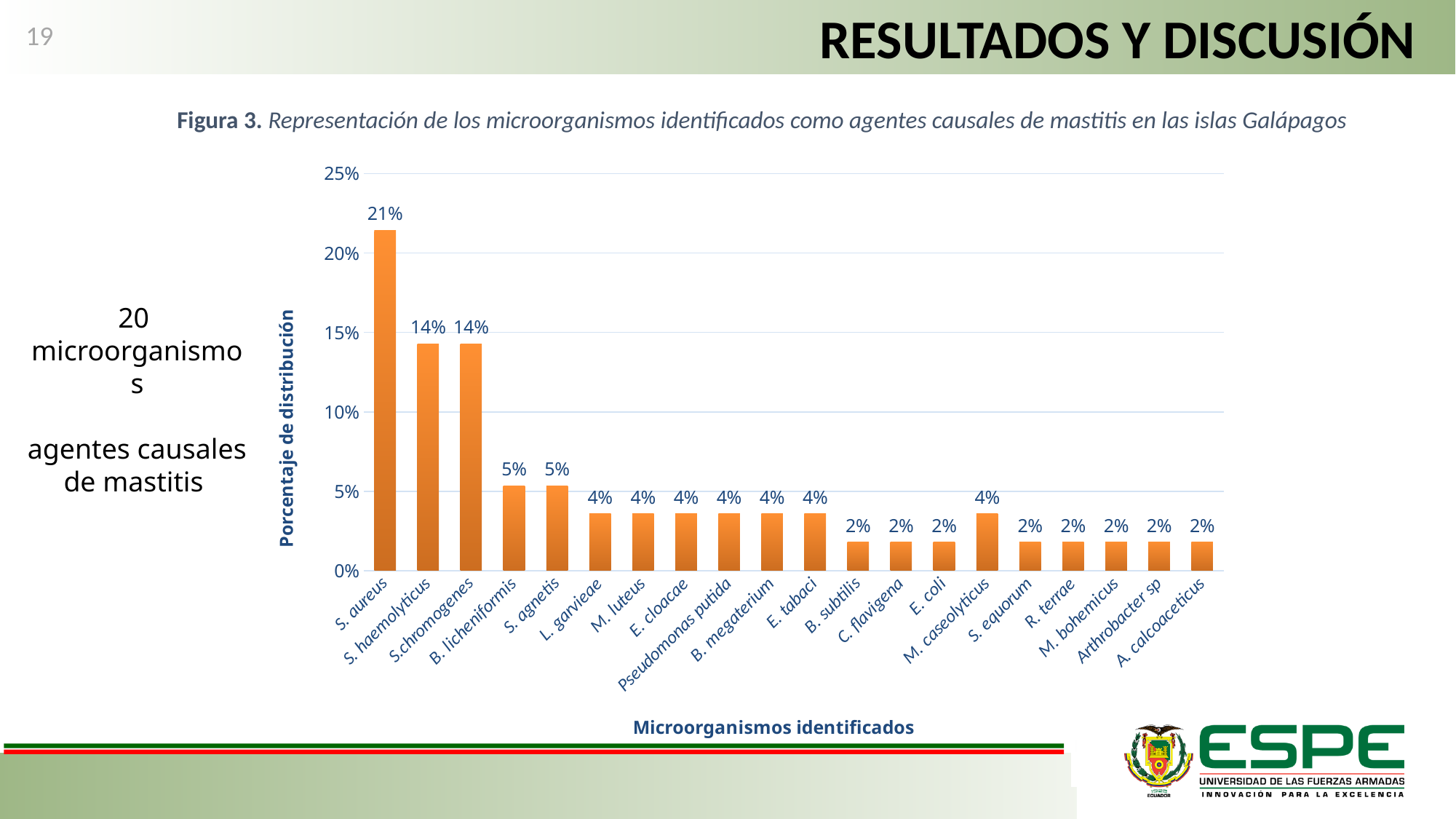
Which is larger, the value for S. agnetis or the value for B. subtilis? S. agnetis Is the value for S. aureus greater or less than 20%? greater Which microorganism has the highest percentage? S. aureus What is the value for M. caseolyticus? 4% What is the value for B. licheniformis? 5% What is the title of the y axis? Porcentaje de distribución What is the value for E. coli? 2% How many microorganisms are shown on the x axis? 20 What is the value for S. aureus? 21% What is the difference between the values for S. aureus and S. haemolyticus? 7% What kind of chart is shown? bar chart Do the values generally rise or fall from left to right along the x axis? fall